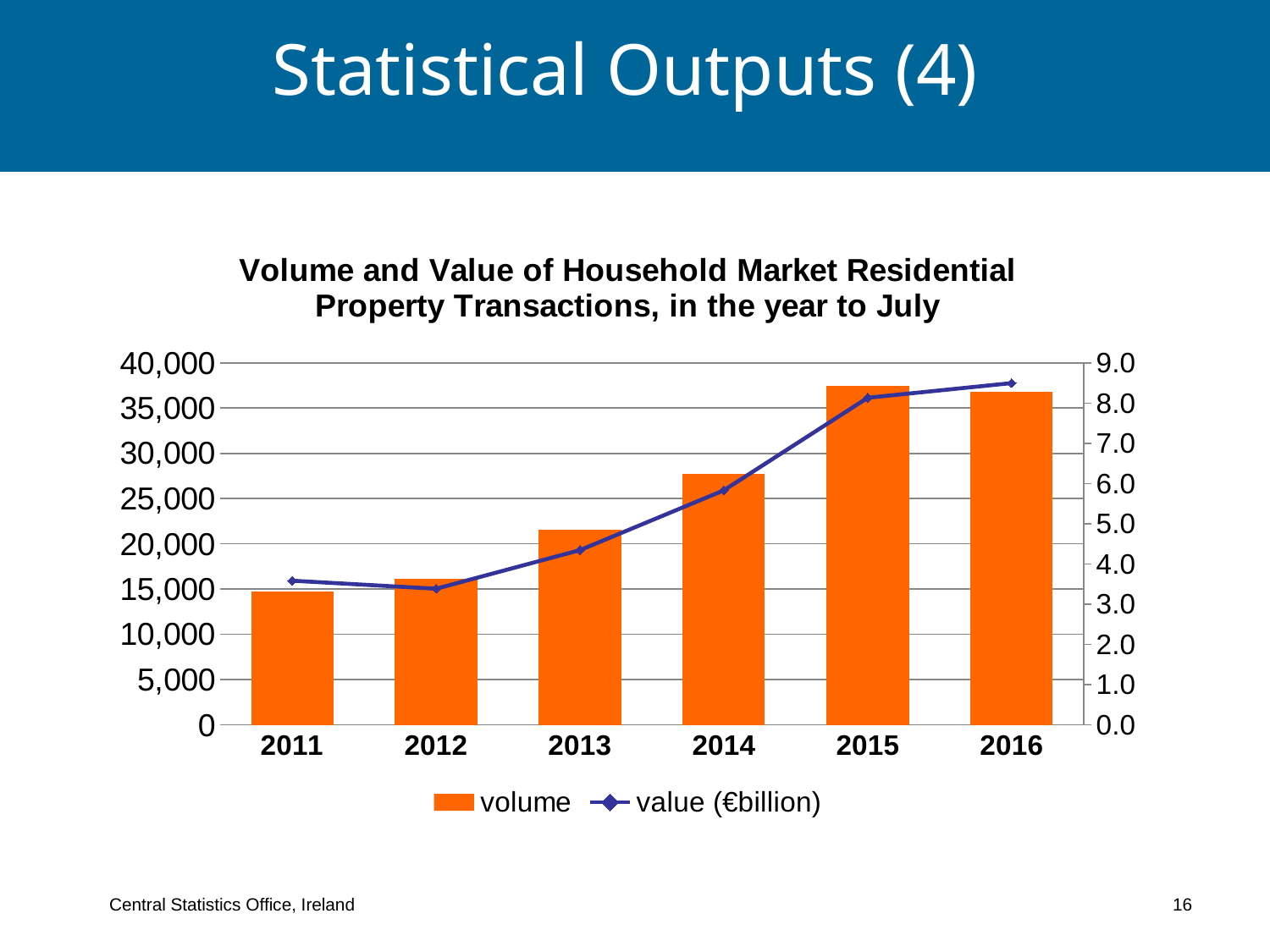
Which year has the lowest volume bar? 2011 How many years are shown on the x axis of the chart? 6 Which year has the larger volume, 2013 or 2014? 2014 How many series does the chart's legend list? 2 Is the volume for 2013 greater or less than 20,000? greater Does the value (€billion) line generally rise or fall from 2012 to 2016? rise Is the volume for 2014 greater or less than 25,000? greater Is the value (€billion) for 2014 greater or less than 5.0? greater What is the title of the chart? Volume and Value of Household Market Residential Property Transactions, in the year to July What kind of chart is shown on the slide? A combined bar and line chart